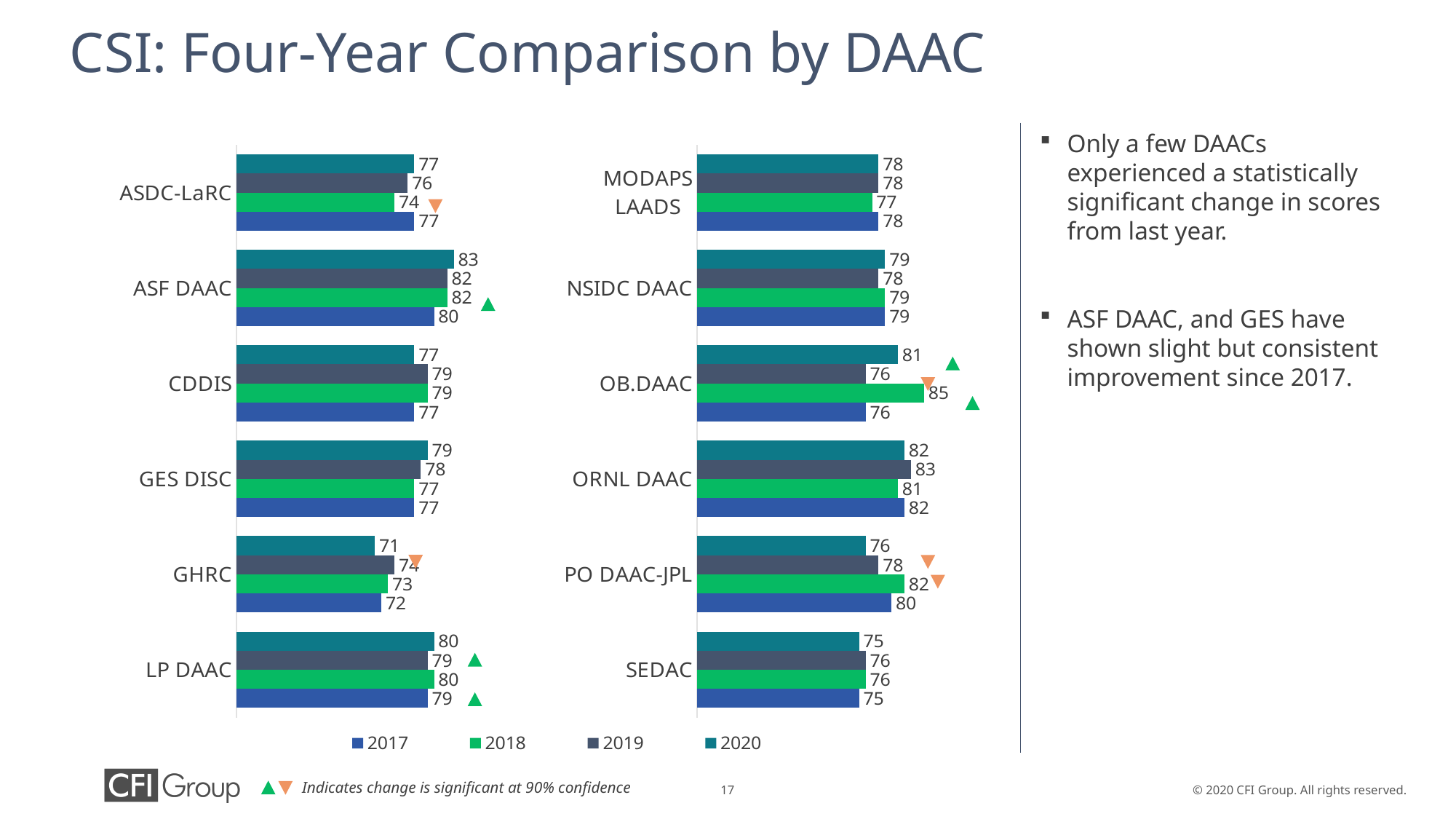
How many DAACs are shown on the left chart? 6 On the right chart, what is the difference between the 2018 and 2019 values for OB.DAAC? 9 On the right chart, what is the 2018 value for OB.DAAC? 85 On the left chart, what is the 2020 value for ASF DAAC? 83 On the right chart, what is the 2017 value for PO DAAC-JPL? 80 On the right chart, which is larger for PO DAAC-JPL: the 2018 value or the 2020 value? 2018 On the left chart, what is the difference between the 2020 and 2017 values for ASF DAAC? 3 How many series does the legend list? 4 What kind of chart is used on the slide? Bar chart On the left chart, what is the 2019 value for GHRC? 74 On the left chart, which DAAC has the lowest 2020 value? GHRC On the right chart, which DAAC has the highest 2018 value? OB.DAAC